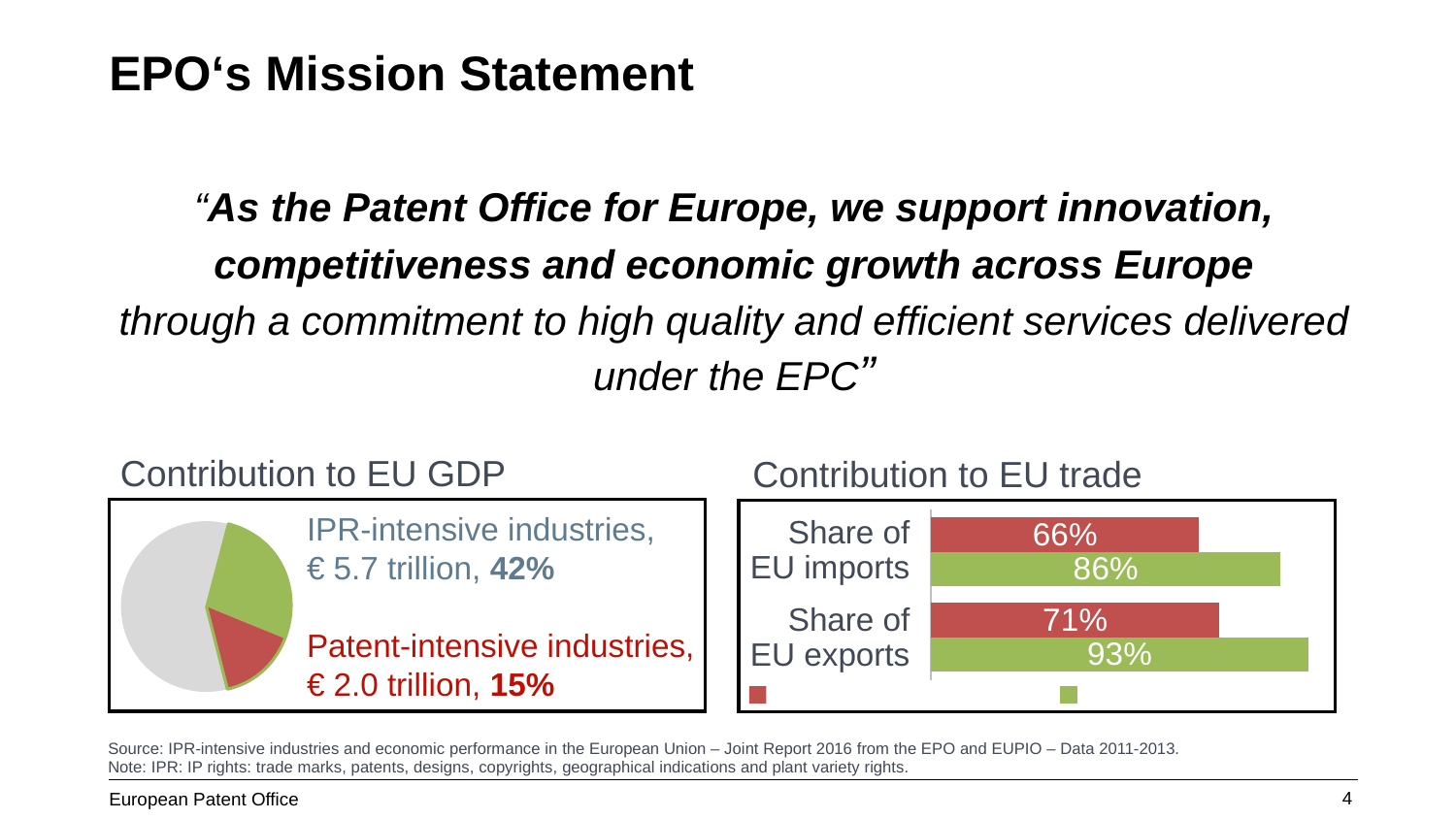
What kind of chart is the 'Contribution to EU GDP' chart? pie chart In the 'Contribution to EU trade' chart, what is the value of the red bar for Share of EU exports? 71% In the 'Contribution to EU trade' chart, which is larger: the red bar for Share of EU imports or the red bar for Share of EU exports? Share of EU exports In the 'Contribution to EU GDP' chart, what is the value in euros for IPR-intensive industries? € 5.7 trillion In the 'Contribution to EU trade' chart, which bar is the highest overall? 93% (green bar, Share of EU exports) In the 'Contribution to EU trade' chart, what is the difference between the green and red bars for Share of EU exports? 22% What kind of chart is the 'Contribution to EU trade' chart? bar chart In the 'Contribution to EU trade' chart, how many categories are shown on the vertical axis? 2 In the 'Contribution to EU trade' chart, what is the value of the green bar for Share of EU imports? 86% In the 'Contribution to EU GDP' chart, what share of EU GDP do IPR-intensive industries contribute? 42% In the 'Contribution to EU GDP' chart, what is the value in euros for patent-intensive industries? € 2.0 trillion In the 'Contribution to EU GDP' chart, what share of EU GDP do patent-intensive industries contribute? 15%